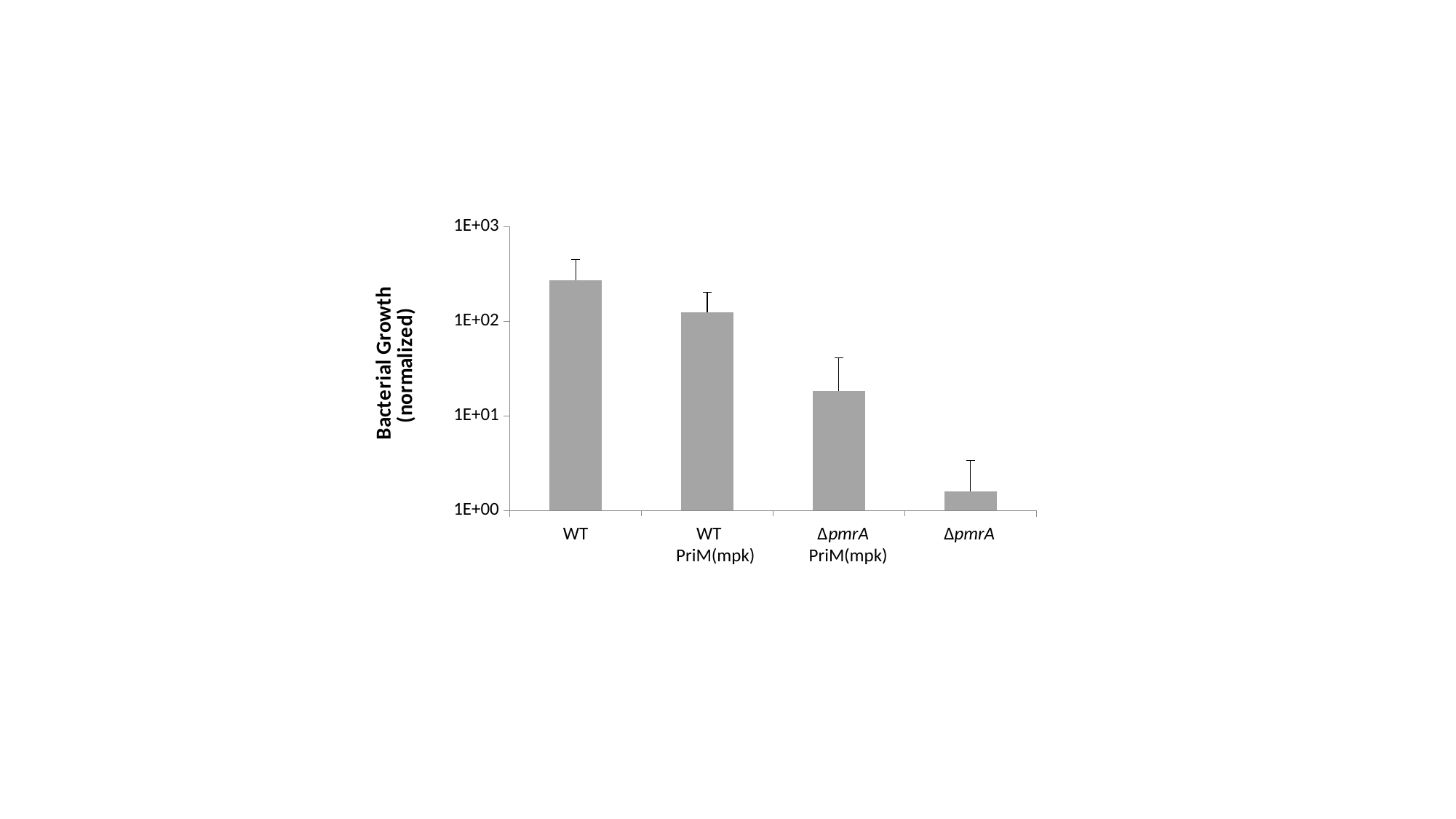
How many categories are plotted on the x axis? 4 Which category has the highest bacterial growth? WT Which category has the lowest bacterial growth? ΔpmrA Is the value for WT greater or less than 1E+02? greater Which is larger, the value for WT or the value for ΔpmrA PriM(mpk)? WT Which is larger, the value for WT PriM(mpk) or the value for ΔpmrA? WT PriM(mpk) Is the value for ΔpmrA PriM(mpk) greater or less than 1E+02? less Is the value for ΔpmrA greater or less than 1E+01? less What kind of chart is shown on the slide? bar chart What is the title of the y axis? Bacterial Growth (normalized) Do the bar values rise or fall from left to right along the x axis? fall